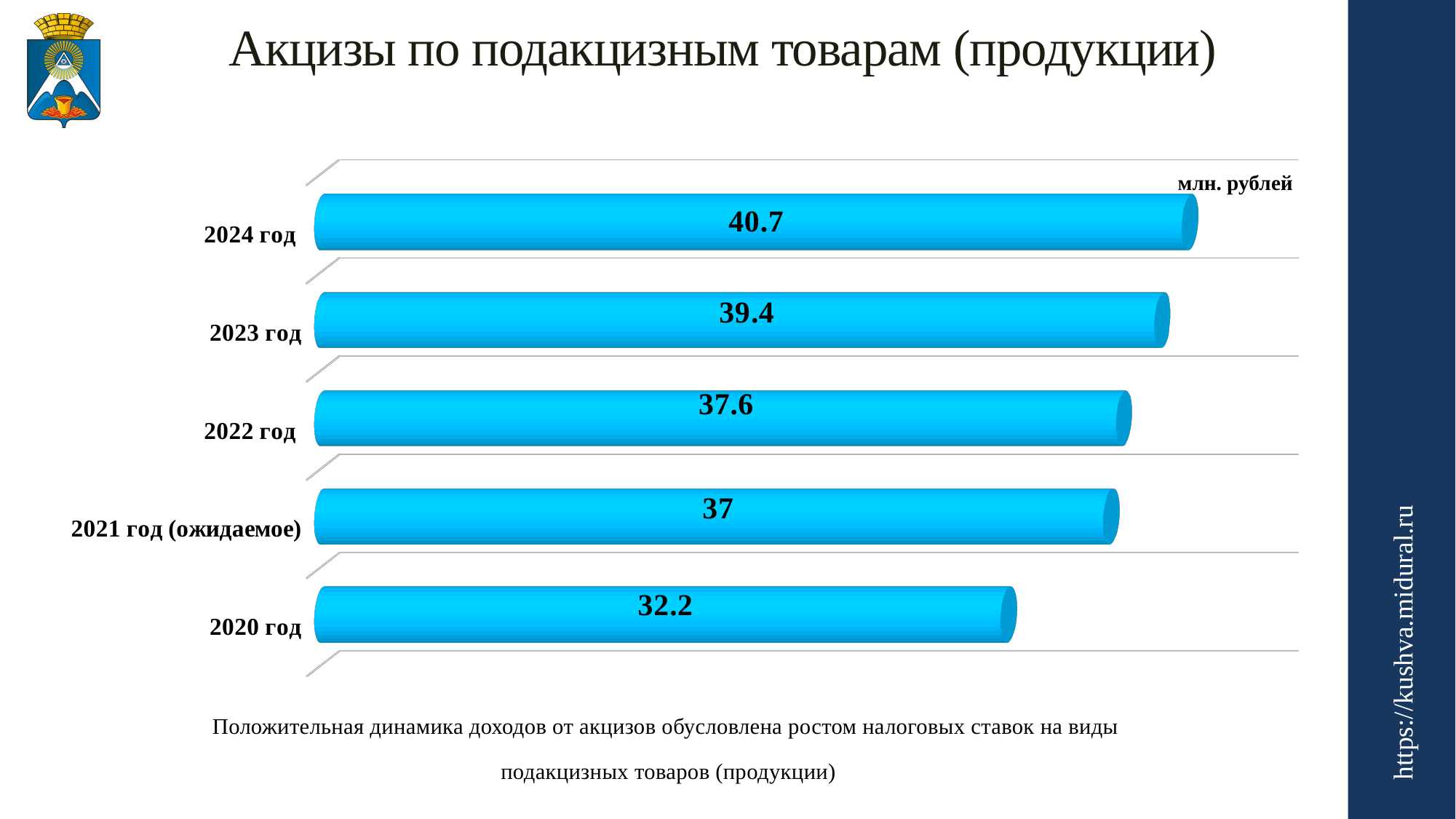
What unit is indicated on the chart? млн. рублей What is the value for 2022 год? 37.6 What is the value for 2024 год? 40.7 Which year has the lowest value? 2020 год Which year has the highest value? 2024 год Which is larger, the value for 2022 год or the value for 2021 год (ожидаемое)? 2022 год How many years are shown in the chart? 5 What kind of chart is shown on the slide? bar chart What is the difference between the values for 2023 год and 2020 год? 7.2 What is the difference between the values for 2024 год and 2023 год? 1.3 What is the value for 2020 год? 32.2 What is the value for 2021 год (ожидаемое)? 37